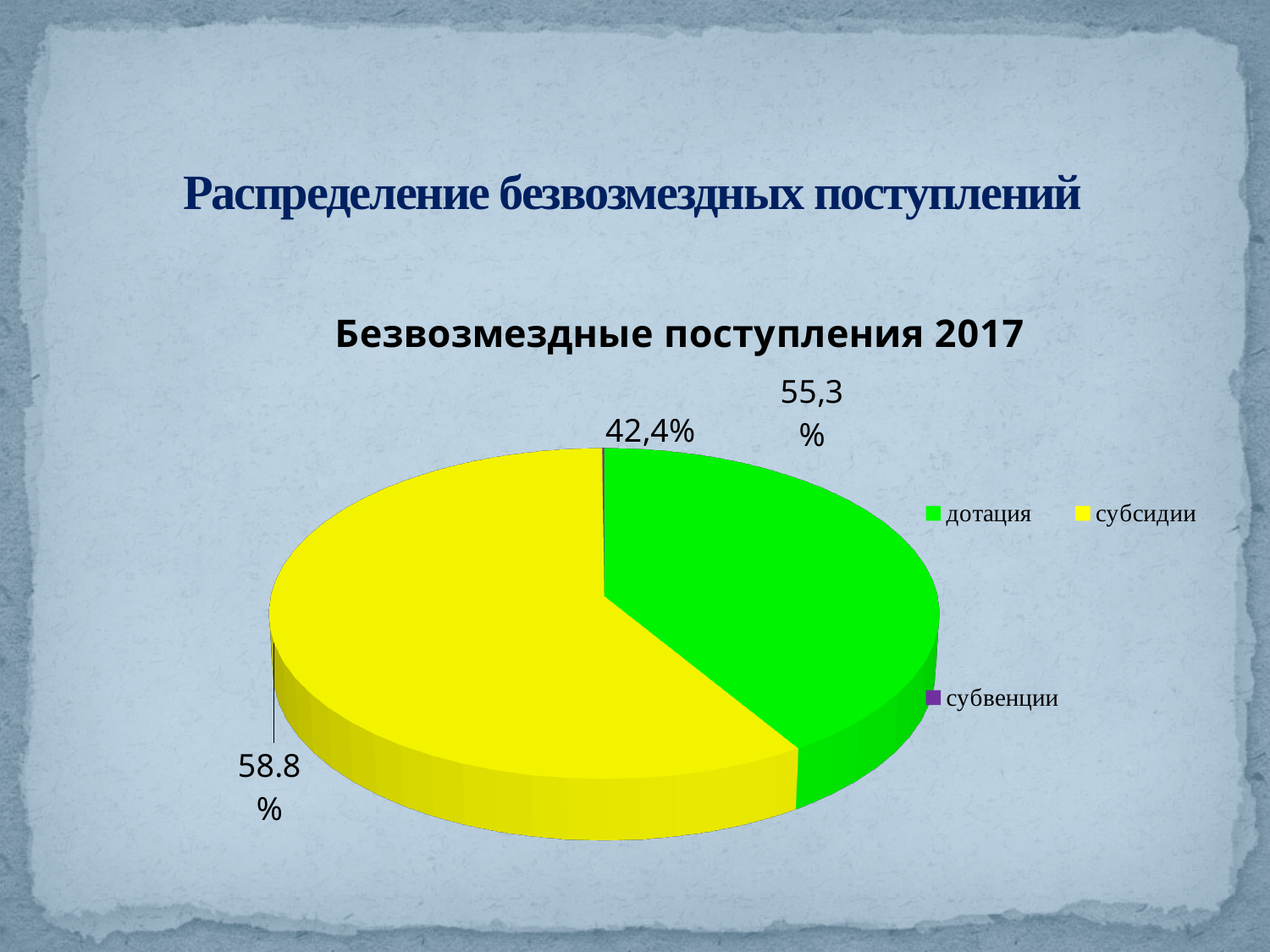
Which slice is larger, дотация or субсидии? субсидии Is the share of the pie for субсидии greater or less than 50%? greater Is the share of the pie for дотация greater or less than 50%? less Which category has the largest slice of the pie? субсидии How many categories does the chart's legend list? 3 What is the title of the chart? Безвозмездные поступления 2017 What data label is printed at the top right of the pie, above the green slice? 55,3% Which colour represents дотация in the chart? green What data label is printed at the lower left of the pie, next to the yellow slice? 58.8% What kind of chart is shown on the slide? pie chart Which category has the smallest slice of the pie? субвенции